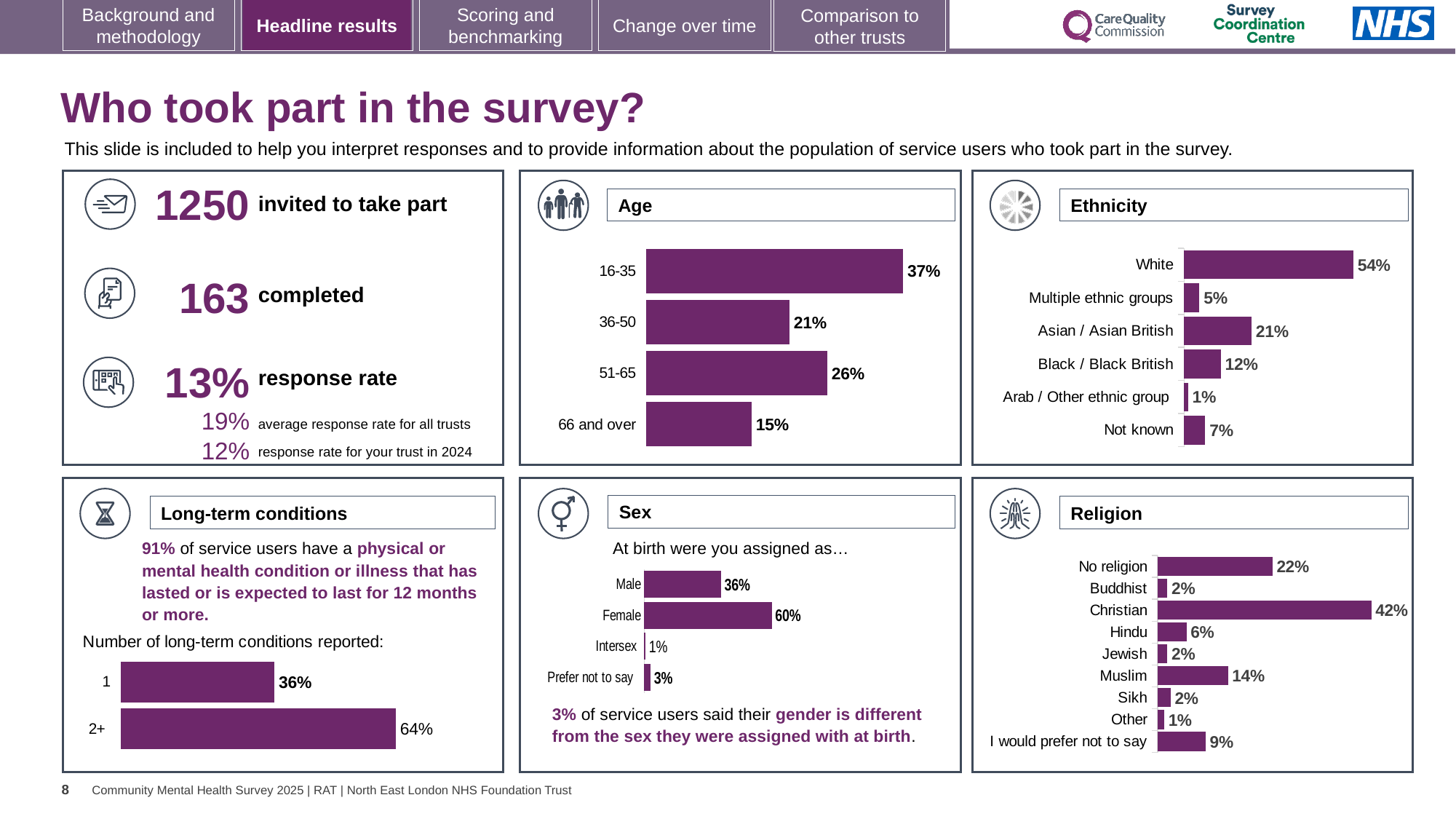
In the Ethnicity chart, how many categories are shown? 6 In the Ethnicity chart, what is the difference between White and Black / Black British? 42% What kind of chart is used in the Age panel? Bar chart In the Age chart, what percentage of respondents were aged 16-35? 37% In the Religion chart, which category has the highest percentage? Christian In the Sex chart, what percentage of respondents were assigned Female at birth? 60% In the Ethnicity chart, what is the value for Asian / Asian British? 21% In the Sex chart, which is larger, Male or Female? Female In the Ethnicity chart, which category has the highest percentage? White In the Age chart, which age group has the lowest percentage? 66 and over In the Religion chart, what is the value for Muslim? 14% In the Long-term conditions chart, what percentage of service users reported 2+ long-term conditions? 64%